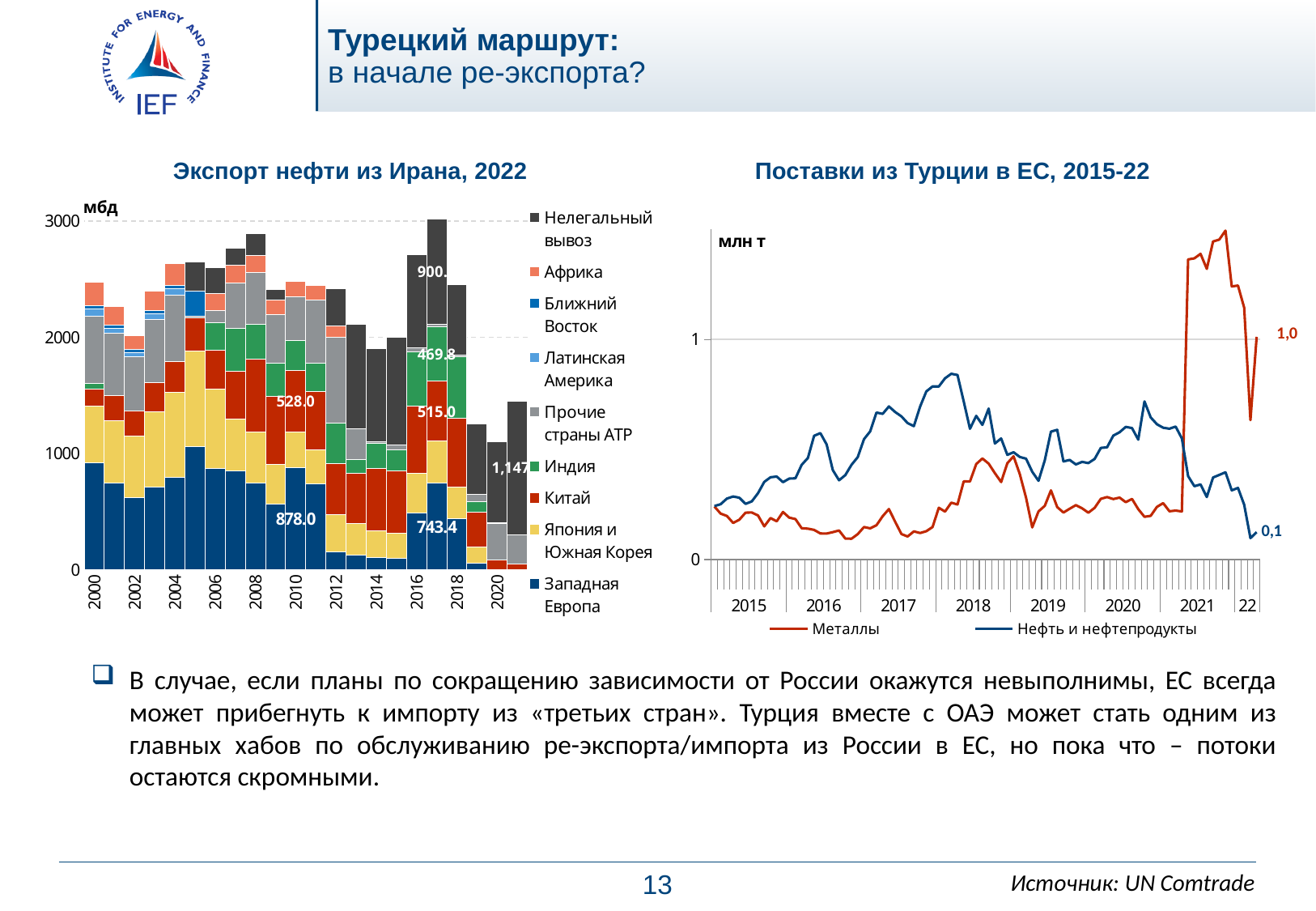
In the right chart 'Поставки из Турции в ЕС, 2015-22', which series ends higher in 2022, Металлы or Нефть и нефтепродукты? Металлы In the right chart 'Поставки из Турции в ЕС, 2015-22', what value is labelled at the end of the Металлы line? 1,0 In the left chart 'Экспорт нефти из Ирана, 2022', what is the labelled value for Китай in 2010? 528.0 In the right chart 'Поставки из Турции в ЕС, 2015-22', what value is labelled at the end of the Нефть и нефтепродукты line? 0,1 What kind of chart is the right chart, 'Поставки из Турции в ЕС, 2015-22'? Line chart In the left chart 'Экспорт нефти из Ирана, 2022', what is the labelled value for Западная Европа in 2010? 878.0 How many series does the legend of the right chart 'Поставки из Турции в ЕС, 2015-22' list? 2 How many series does the legend of the left chart 'Экспорт нефти из Ирана, 2022' list? 9 In the right chart 'Поставки из Турции в ЕС, 2015-22', is the value of Нефть и нефтепродукты at its 2018 peak greater or less than 1? less In the left chart 'Экспорт нефти из Ирана, 2022', which is larger in 2017, the value for Западная Европа or the value for Китай? Западная Европа What kind of chart is the left chart, 'Экспорт нефти из Ирана, 2022'? Stacked bar chart In the left chart 'Экспорт нефти из Ирана, 2022', what is the difference between the labelled values for Западная Европа (878.0) and Китай (528.0) in 2010? 350.0